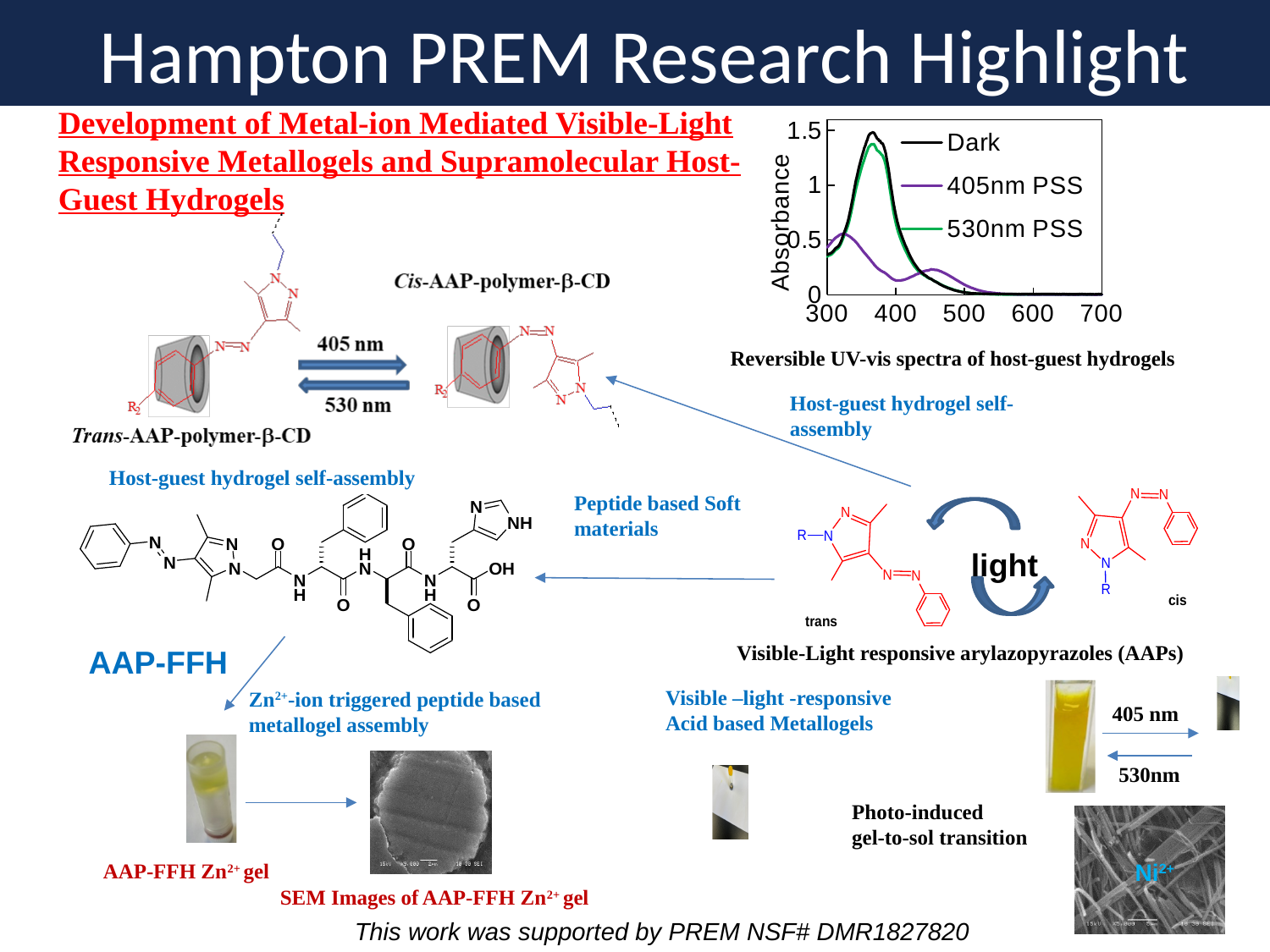
In the UV-vis spectra chart, is the peak absorbance of the Dark series greater or less than 1? greater In the UV-vis spectra chart, at the peak near 370 nm, which series has the larger absorbance: Dark or 405nm PSS? Dark In the UV-vis spectra chart, which series reaches the highest peak absorbance? Dark What kind of chart is the UV-vis spectra chart on the slide? line chart How many series does the legend of the UV-vis spectra chart list? 3 What is the y-axis label of the UV-vis spectra chart? Absorbance What are the three series named in the legend of the UV-vis spectra chart? Dark, 405nm PSS, 530nm PSS In the UV-vis spectra chart, which series has the lowest maximum absorbance? 405nm PSS In the UV-vis spectra chart, is the maximum absorbance of the 405nm PSS series greater or less than 1? less In the UV-vis spectra chart, does the absorbance of the Dark series rise or fall as wavelength increases from 400 nm to 700 nm? fall In the UV-vis spectra chart, is the peak absorbance of the 530nm PSS series greater or less than 1? greater